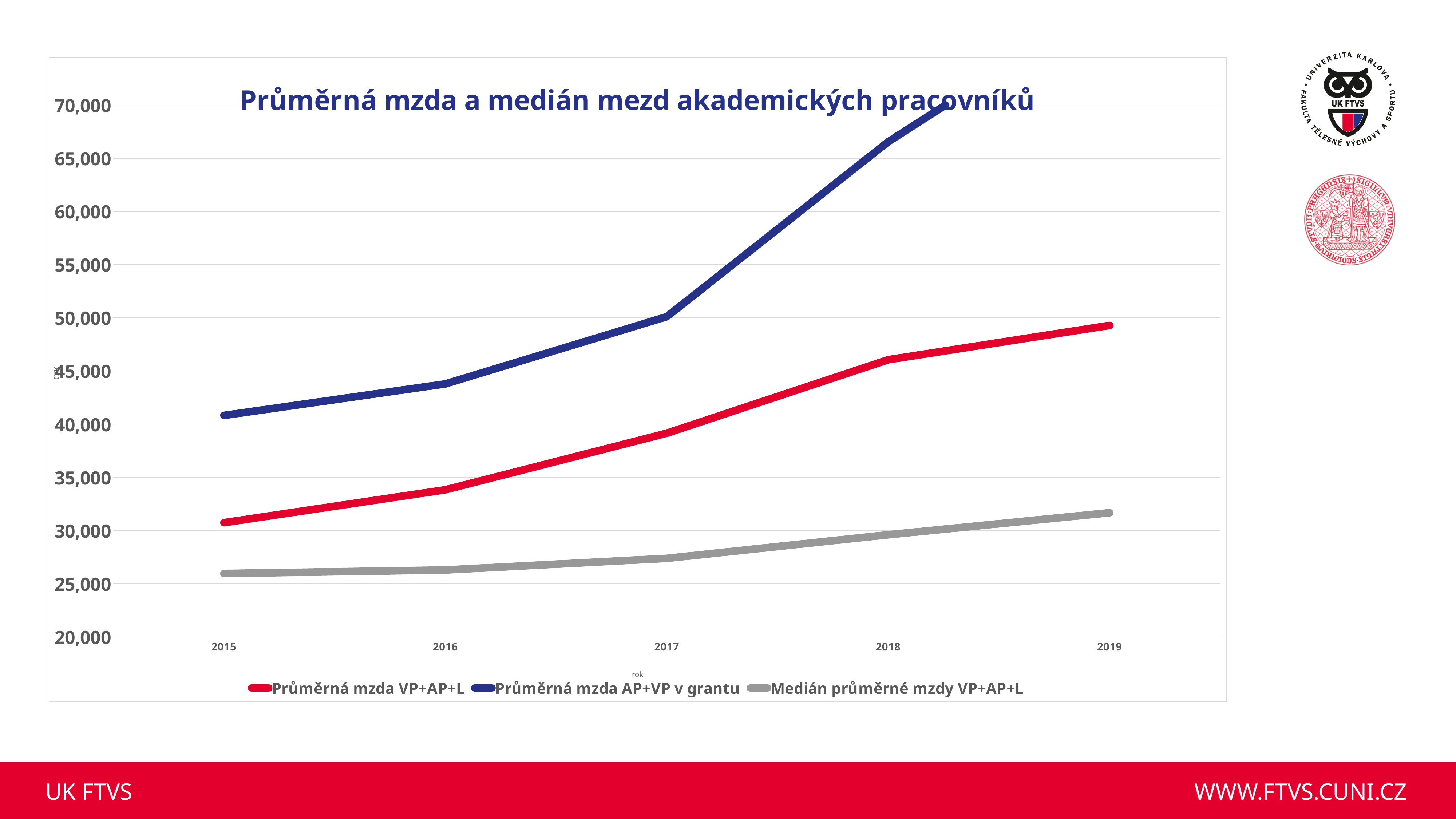
Do the values for Průměrná mzda VP+AP+L rise or fall from 2015 to 2019? rise How many series does the legend list? 3 Is the value for Průměrná mzda VP+AP+L in 2015 greater or less than 35,000? less Which is larger in 2017: Průměrná mzda VP+AP+L or Medián průměrné mzdy VP+AP+L? Průměrná mzda VP+AP+L What type of chart is shown on the slide? line chart Is the value for Průměrná mzda AP+VP v grantu in 2018 greater or less than 60,000? greater In which year is Průměrná mzda AP+VP v grantu highest? 2019 Is the value for Medián průměrné mzdy VP+AP+L in 2019 greater or less than 30,000? greater How many years are shown on the x axis? 5 Which series is drawn in blue? Průměrná mzda AP+VP v grantu What is the title of the chart? Průměrná mzda a medián mezd akademických pracovníků